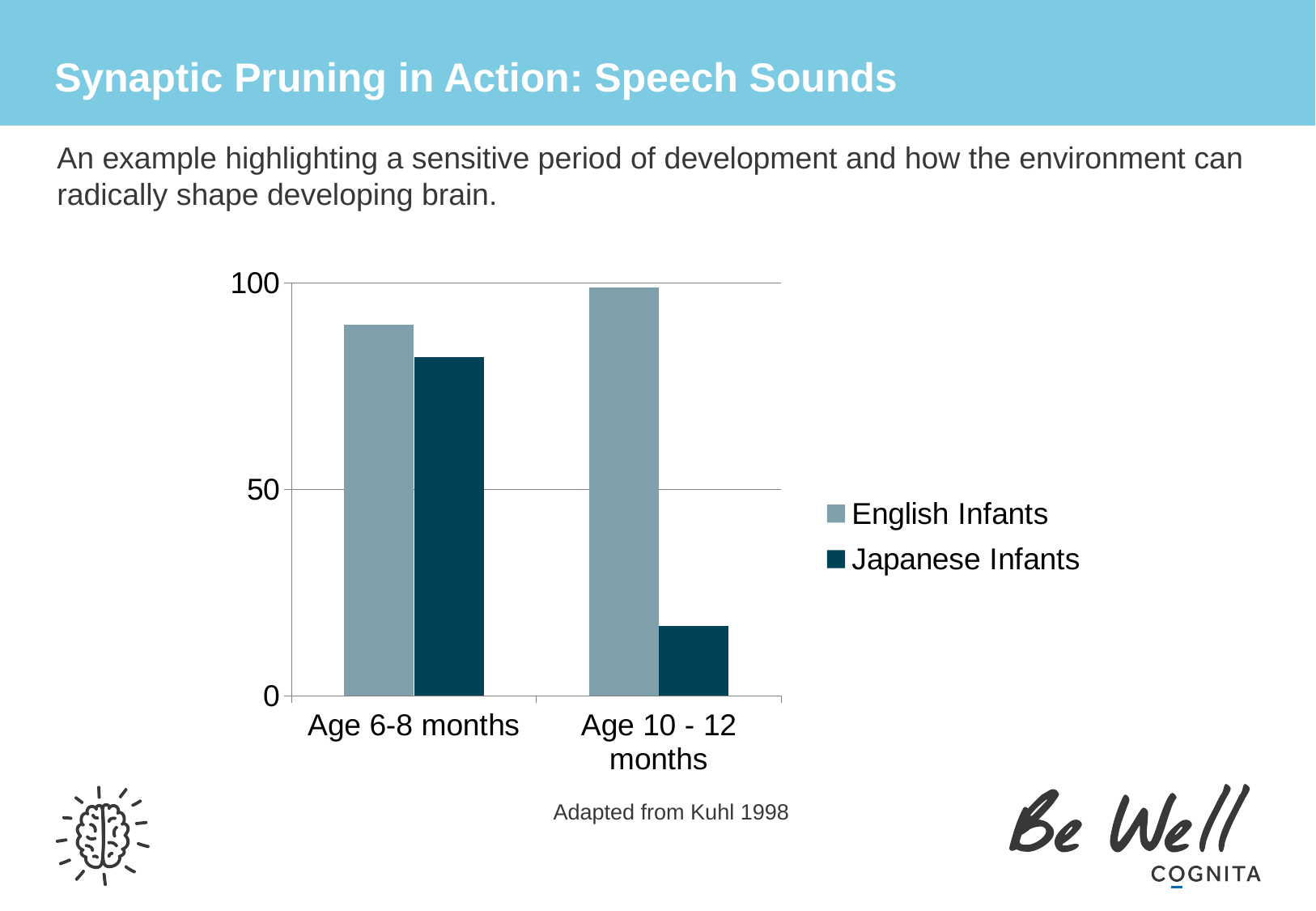
How many age categories are shown on the x axis of the chart? 2 What kind of chart is shown on the slide? bar chart Which bar in the chart is the highest? English Infants, Age 10 - 12 months Which bar in the chart is the lowest? Japanese Infants, Age 10 - 12 months Do the values for English Infants rise or fall from Age 6-8 months to Age 10 - 12 months? rise What source is the chart adapted from, according to the note below it? Kuhl 1998 Is the value for Japanese Infants at Age 10 - 12 months greater or less than 50? less Is the value for Japanese Infants at Age 6-8 months greater or less than 50? greater Is the value for English Infants at Age 6-8 months greater or less than 50? greater Do the values for Japanese Infants rise or fall from Age 6-8 months to Age 10 - 12 months? fall At Age 6-8 months, which is larger: the value for English Infants or Japanese Infants? English Infants How many series does the chart legend list? 2